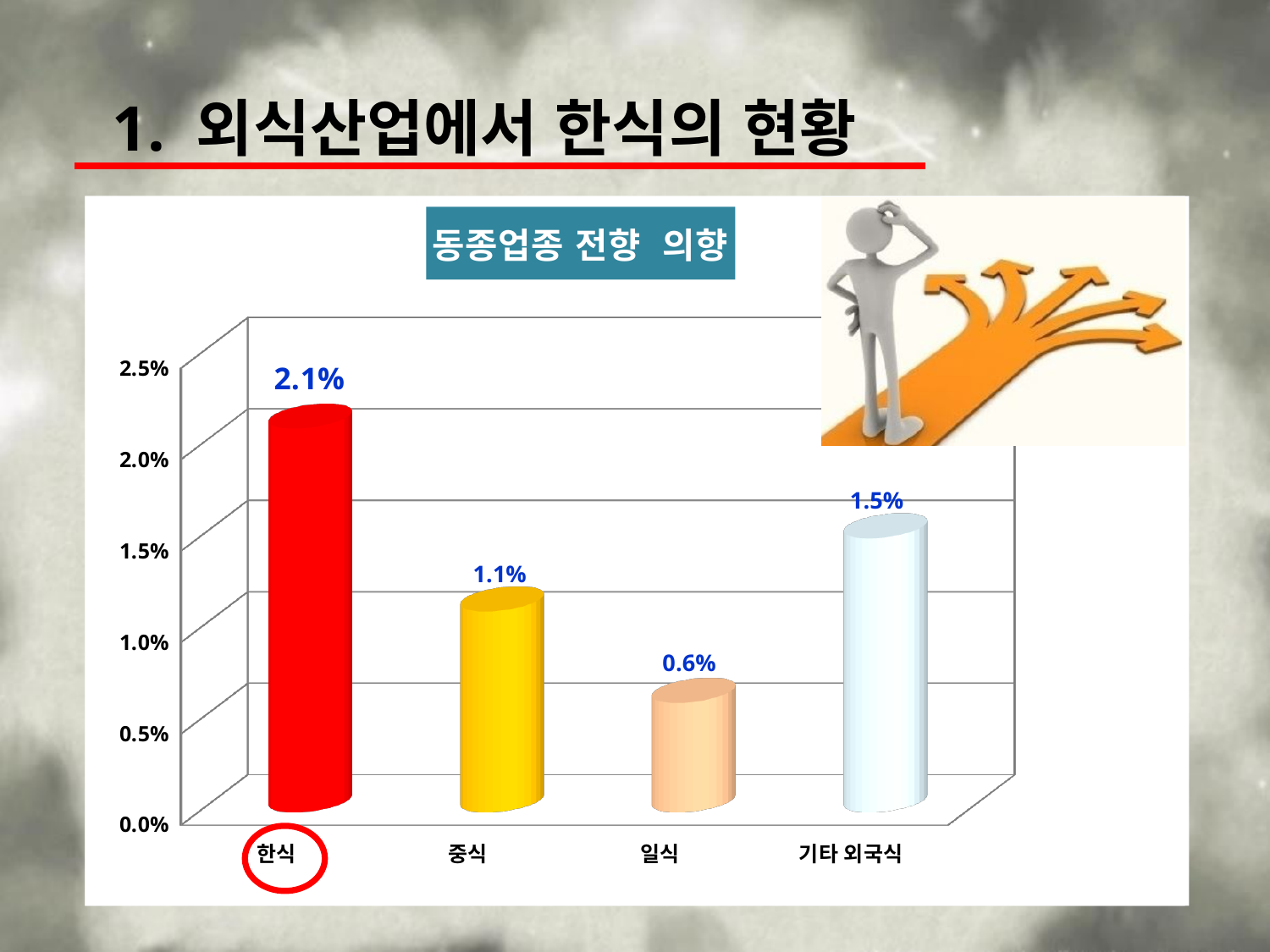
How many categories are shown on the chart? 4 Which is larger, the value for 중식 or the value for 기타 외국식? 기타 외국식 What kind of chart is shown on the slide? bar chart What is the value for 중식? 1.1% What is the value for 한식? 2.1% What is the difference between the values for 한식 and 기타 외국식? 0.6% What is the difference between the values for 중식 and 일식? 0.5% What is the value for 기타 외국식? 1.5% Which category has the highest value? 한식 What is the value for 일식? 0.6% What is the title of the chart? 동종업종 전향 의향 Which category has the lowest value? 일식